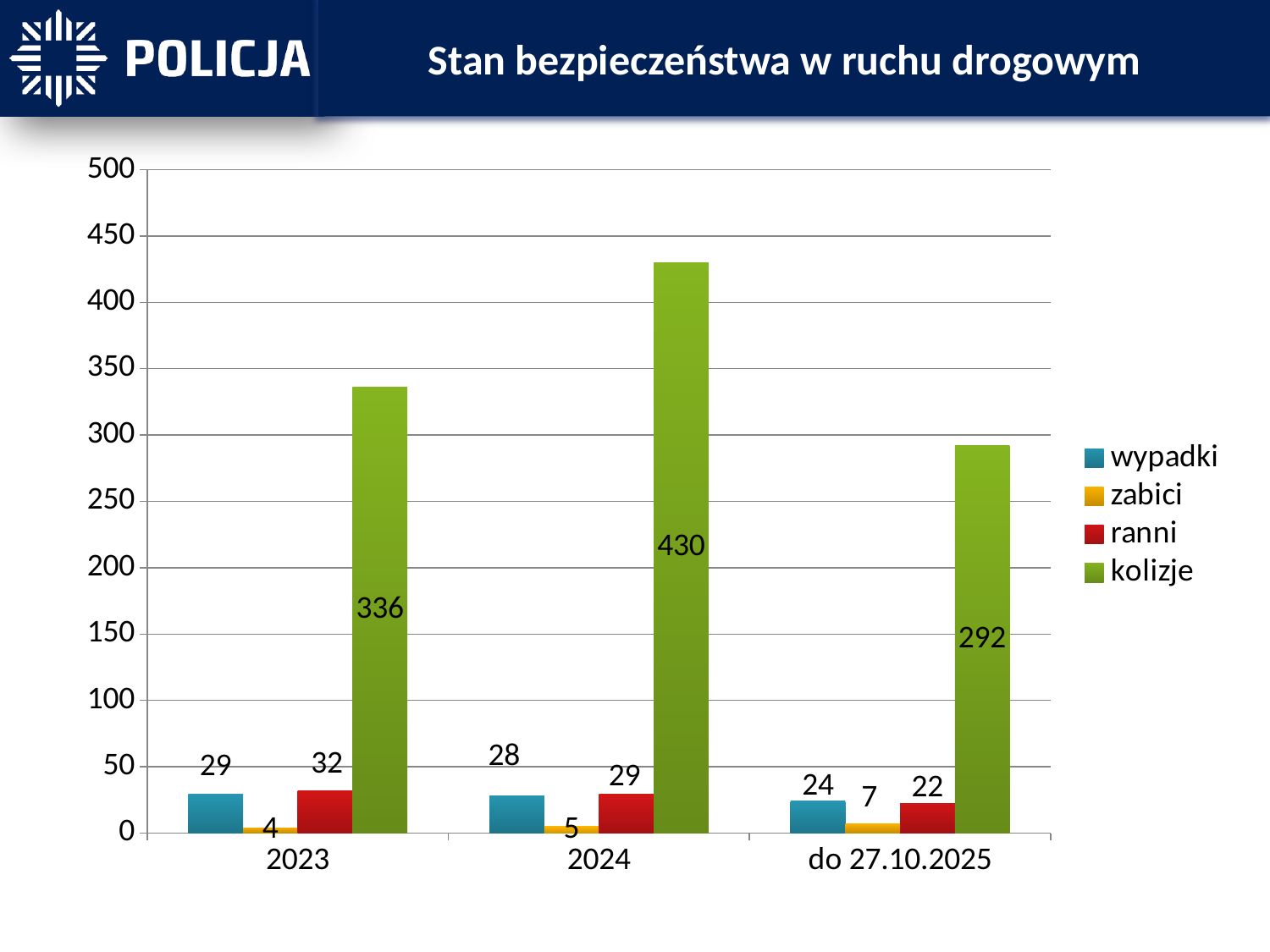
In which year is the kolizje value highest? 2024 What is the value of ranni for 2024? 29 In which period is the zabici value lowest? 2023 What is the value of kolizje for 2024? 430 What is the value of zabici for do 27.10.2025? 7 What is the difference between kolizje in 2024 and kolizje in 2023? 94 Which is larger: ranni in 2023 or ranni in do 27.10.2025? ranni in 2023 How many series does the legend list? 4 How many categories are shown on the x axis? 3 What is the value of wypadki for 2023? 29 What kind of chart is shown on the slide? bar chart Is the value of kolizje for do 27.10.2025 greater or less than 300? less